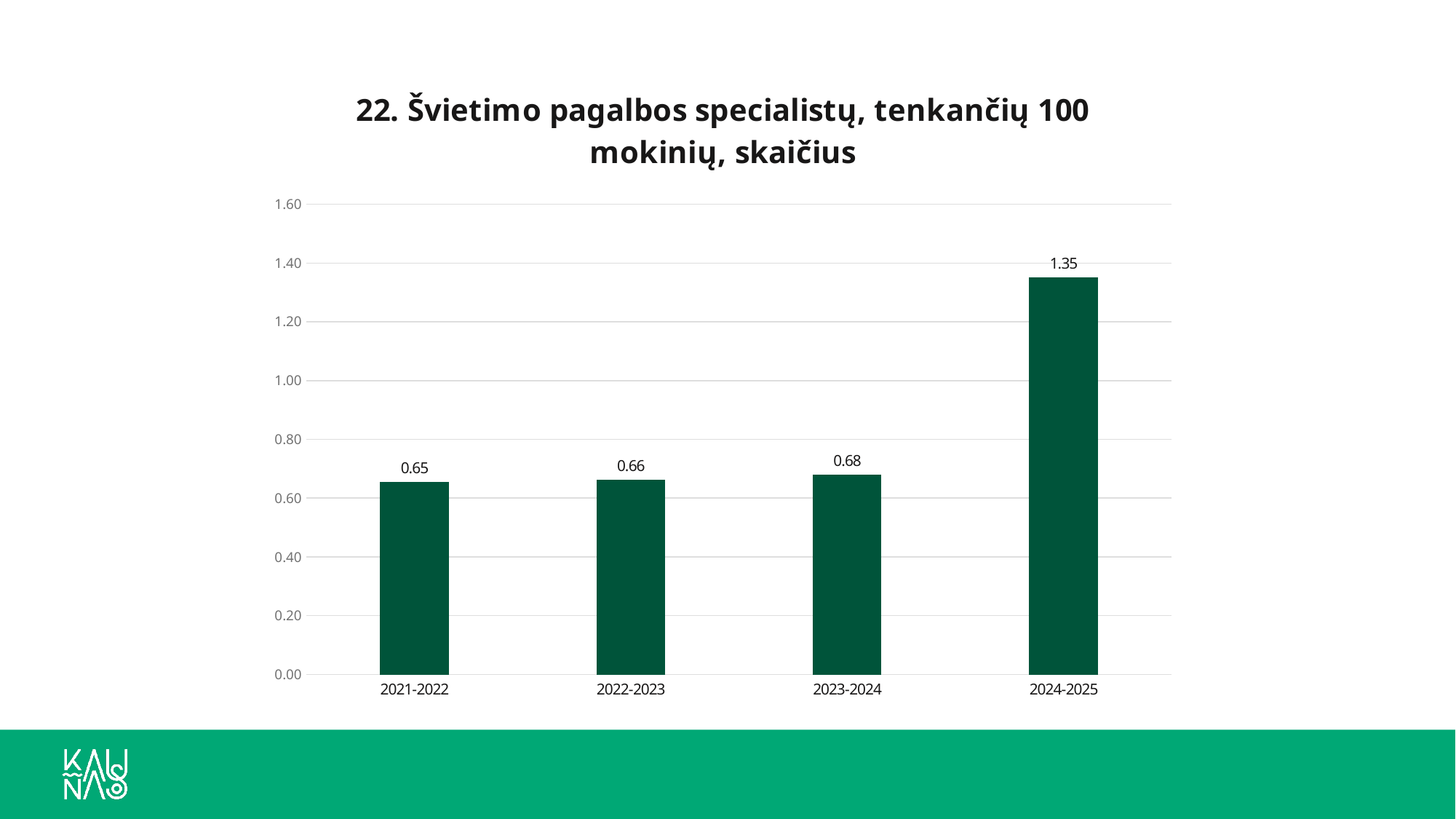
What kind of chart is shown on the slide? bar chart What is the value for 2024-2025? 1.35 Is the value for 2024-2025 greater or less than 1.00? greater How many school years are shown on the chart? 4 What is the difference between the values for 2024-2025 and 2023-2024? 0.67 Which is larger, the value for 2024-2025 or the value for 2022-2023? 2024-2025 Which school year has the lowest value? 2021-2022 Do the values rise or fall from 2021-2022 to 2024-2025? rise What is the difference between the values for 2022-2023 and 2021-2022? 0.01 Which school year has the highest value? 2024-2025 What is the value for 2023-2024? 0.68 What is the value for 2021-2022? 0.65